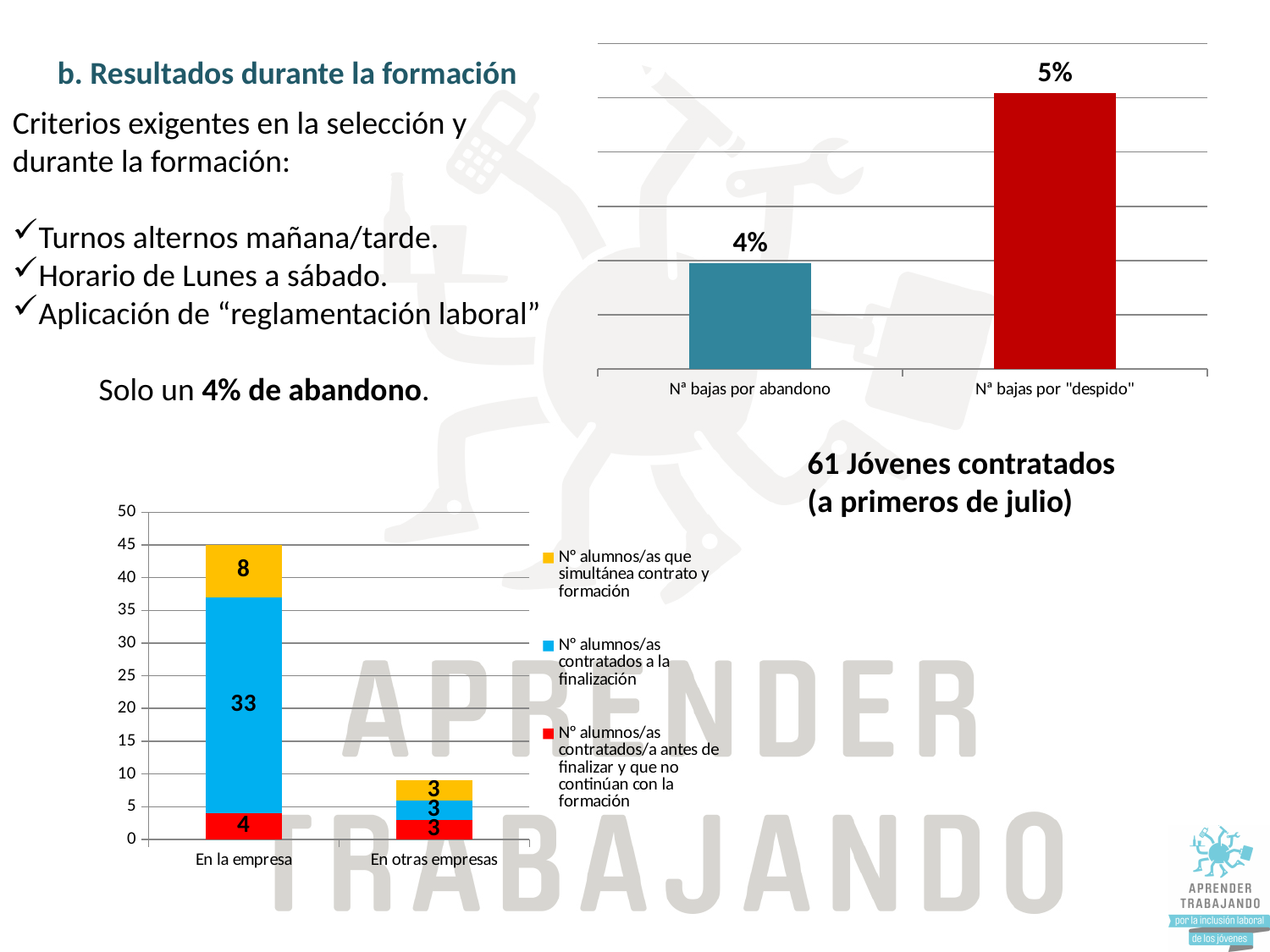
In the bottom-left stacked chart, what is the total of the En otras empresas bar? 9 In the bottom-left stacked chart, what is the value of Nº alumnos/as contratados a la finalización for En la empresa? 33 What kind of chart is the bottom-left chart? Stacked bar chart In the top-right chart, what is the value for Nª bajas por abandono? 4% In the bottom-left stacked chart, what is the total of the En la empresa bar? 45 In the top-right chart, what is the difference between Nª bajas por "despido" and Nª bajas por abandono? 1% In the top-right chart, what is the value for Nª bajas por "despido"? 5% In the bottom-left stacked chart, how many series does the legend list? 3 In the bottom-left stacked chart, which category has the larger total, En la empresa or En otras empresas? En la empresa In the top-right chart, how many categories are shown? 2 In the bottom-left stacked chart, what is the value of Nº alumnos/as que simultánea contrato y formación for En la empresa? 8 In the top-right chart, which category has the higher value? Nª bajas por "despido"